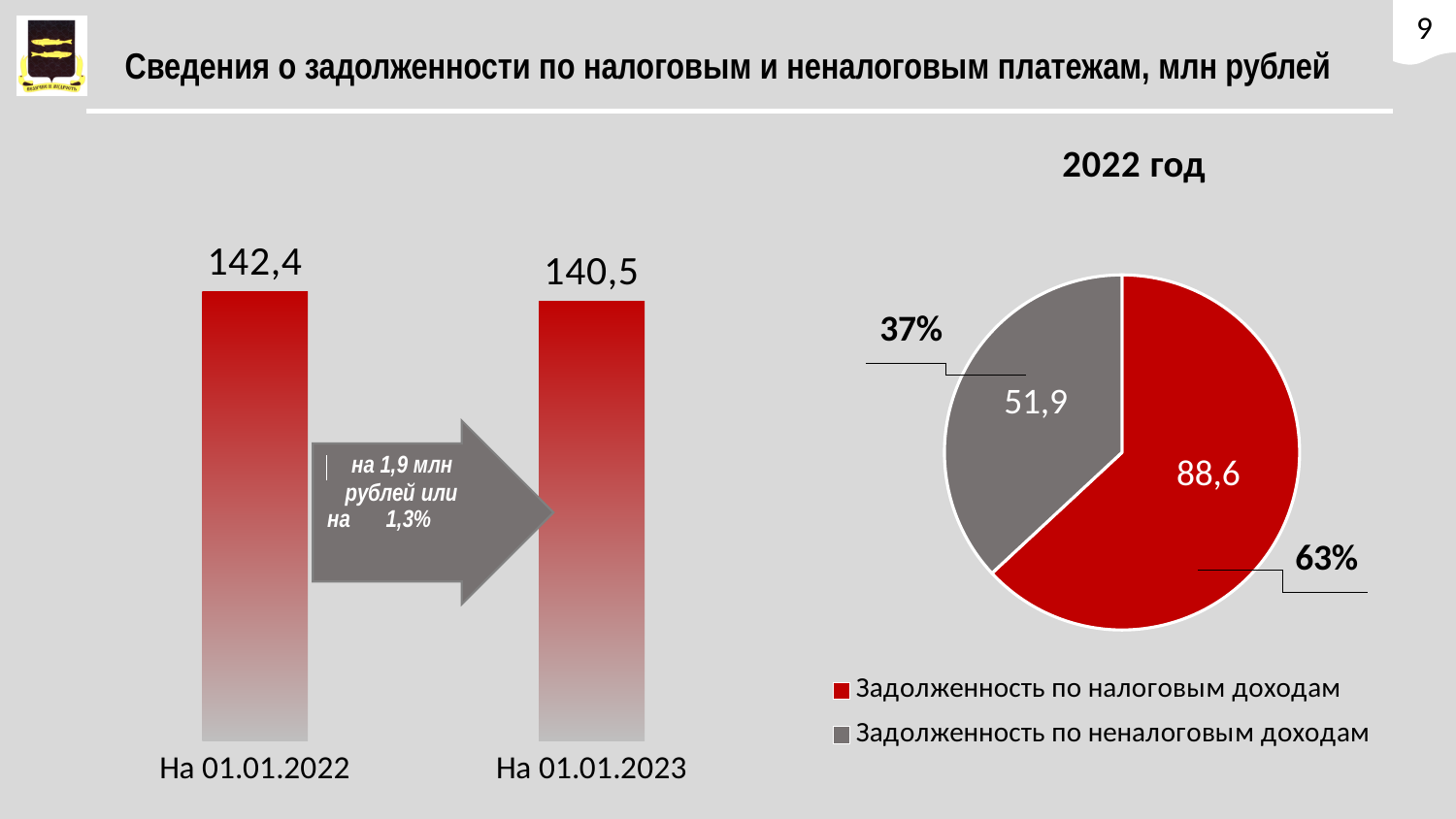
On the bar chart on the left, do the values rise or fall from На 01.01.2022 to На 01.01.2023? fall On the pie chart titled 2022 год, what is the value for Задолженность по налоговым доходам? 88,6 On the pie chart titled 2022 год, how many entries does the legend list? 2 On the bar chart on the left, which category has the higher value? На 01.01.2022 On the bar chart on the left, what is the difference between the values for На 01.01.2022 and На 01.01.2023? 1,9 On the bar chart on the left, how many bars are plotted? 2 On the bar chart on the left, what is the value for На 01.01.2022? 142,4 On the pie chart titled 2022 год, which slice is larger: Задолженность по налоговым доходам or Задолженность по неналоговым доходам? Задолженность по налоговым доходам On the pie chart titled 2022 год, what is the value for Задолженность по неналоговым доходам? 51,9 On the pie chart titled 2022 год, what share does Задолженность по неналоговым доходам have? 37% What kind of chart is shown on the left of the slide? bar chart On the bar chart on the left, what is the value for На 01.01.2023? 140,5